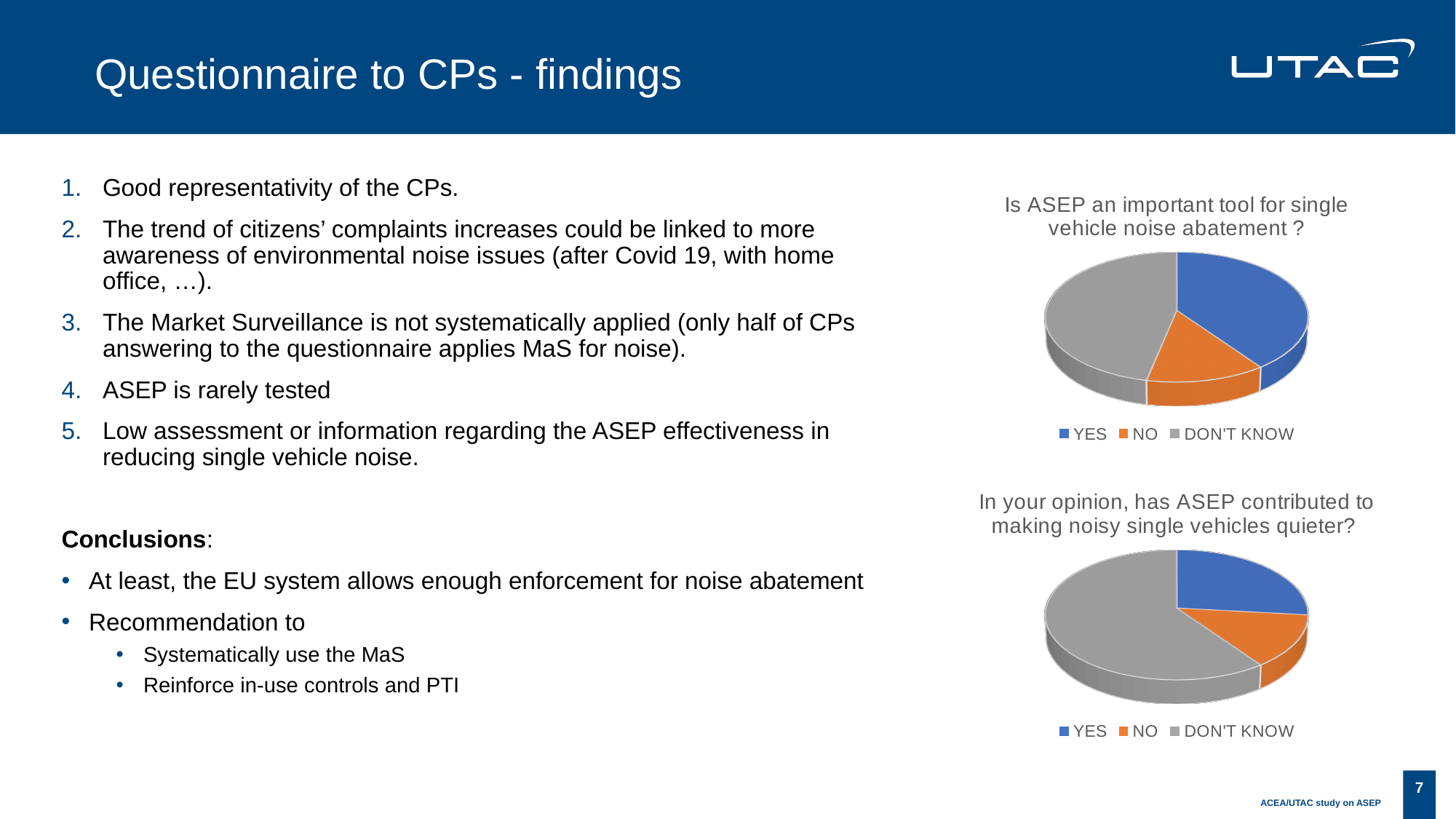
What is the title of the bottom pie chart on the slide? In your opinion, has ASEP contributed to making noisy single vehicles quieter? In the top pie chart ("Is ASEP an important tool for single vehicle noise abatement ?"), which category has the smallest slice? NO What kind of chart is the chart titled "Is ASEP an important tool for single vehicle noise abatement ?"? Pie chart In the top pie chart ("Is ASEP an important tool for single vehicle noise abatement ?"), how many slices are there? 3 In the bottom pie chart ("In your opinion, has ASEP contributed to making noisy single vehicles quieter?"), which slice is larger, YES or DON'T KNOW? DON'T KNOW In the top pie chart, what colour represents the DON'T KNOW category? Grey In the bottom pie chart ("In your opinion, has ASEP contributed to making noisy single vehicles quieter?"), which category has the largest slice? DON'T KNOW What kind of chart is the chart titled "In your opinion, has ASEP contributed to making noisy single vehicles quieter?"? Pie chart In the bottom pie chart ("In your opinion, has ASEP contributed to making noisy single vehicles quieter?"), which category has the smallest slice? NO In the top pie chart ("Is ASEP an important tool for single vehicle noise abatement ?"), which slice is larger, YES or NO? YES In the bottom pie chart ("In your opinion, has ASEP contributed to making noisy single vehicles quieter?"), how many categories does the legend list? 3